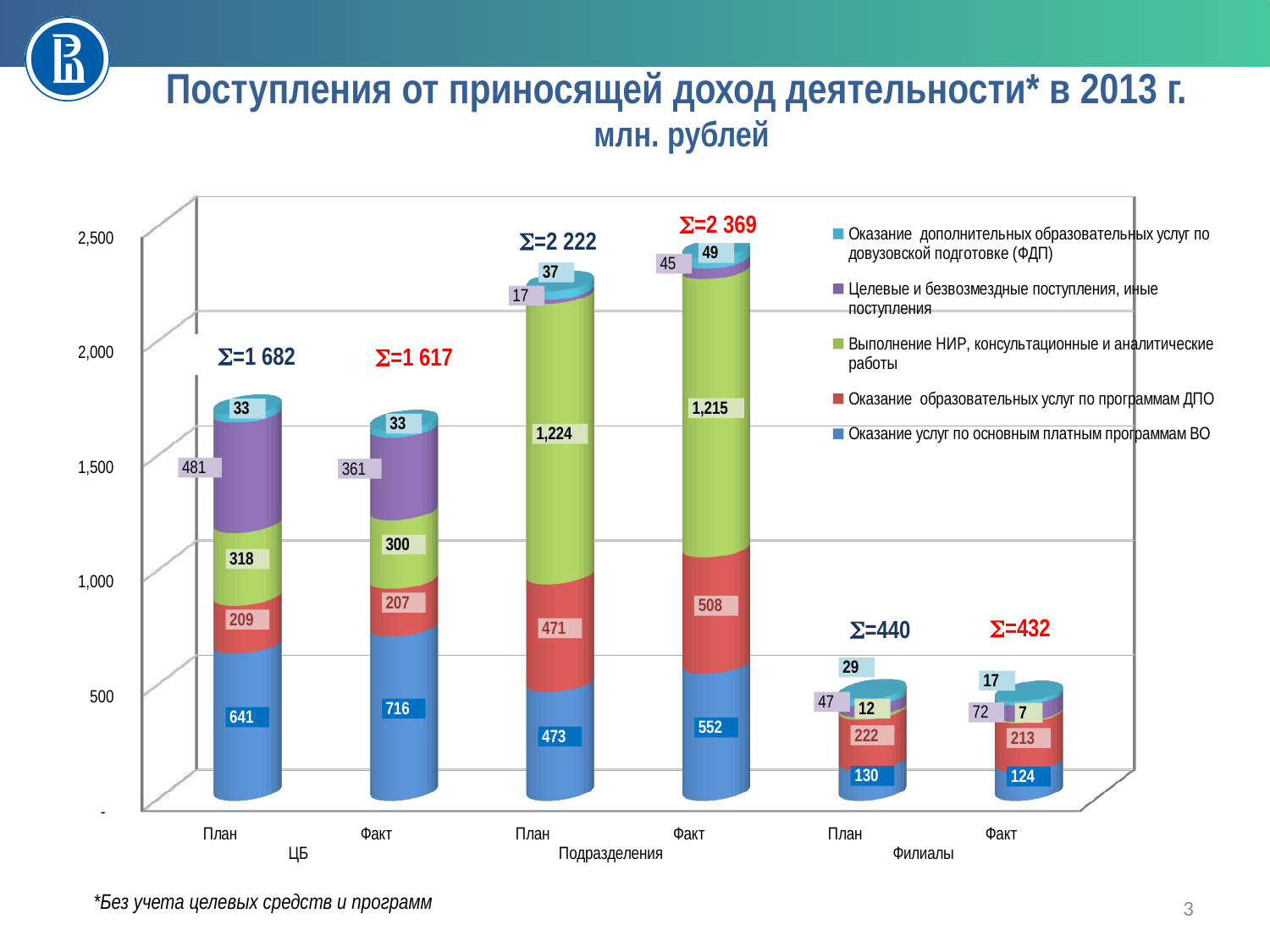
What kind of chart is shown on the slide? stacked bar chart What is the difference between the 'Оказание образовательных услуг по программам ДПО' values for Подразделения Факт and Подразделения План? 37 Which bar has the lowest total? Филиалы Факт What is the value of 'Выполнение НИР, консультационные и аналитические работы' for Подразделения Факт? 1,215 Which bar has the highest total? Подразделения Факт How many bars are plotted in the chart? 6 What is the unit of measurement stated under the chart title? млн. рублей What is the total (Σ) shown for the Филиалы План bar? 440 Which is larger: the 'Целевые и безвозмездные поступления, иные поступления' value for ЦБ План or for ЦБ Факт? ЦБ План What is the total (Σ) shown for the Подразделения Факт bar? 2 369 How many series does the legend list? 5 What is the value of 'Оказание услуг по основным платным программам ВО' for ЦБ План? 641